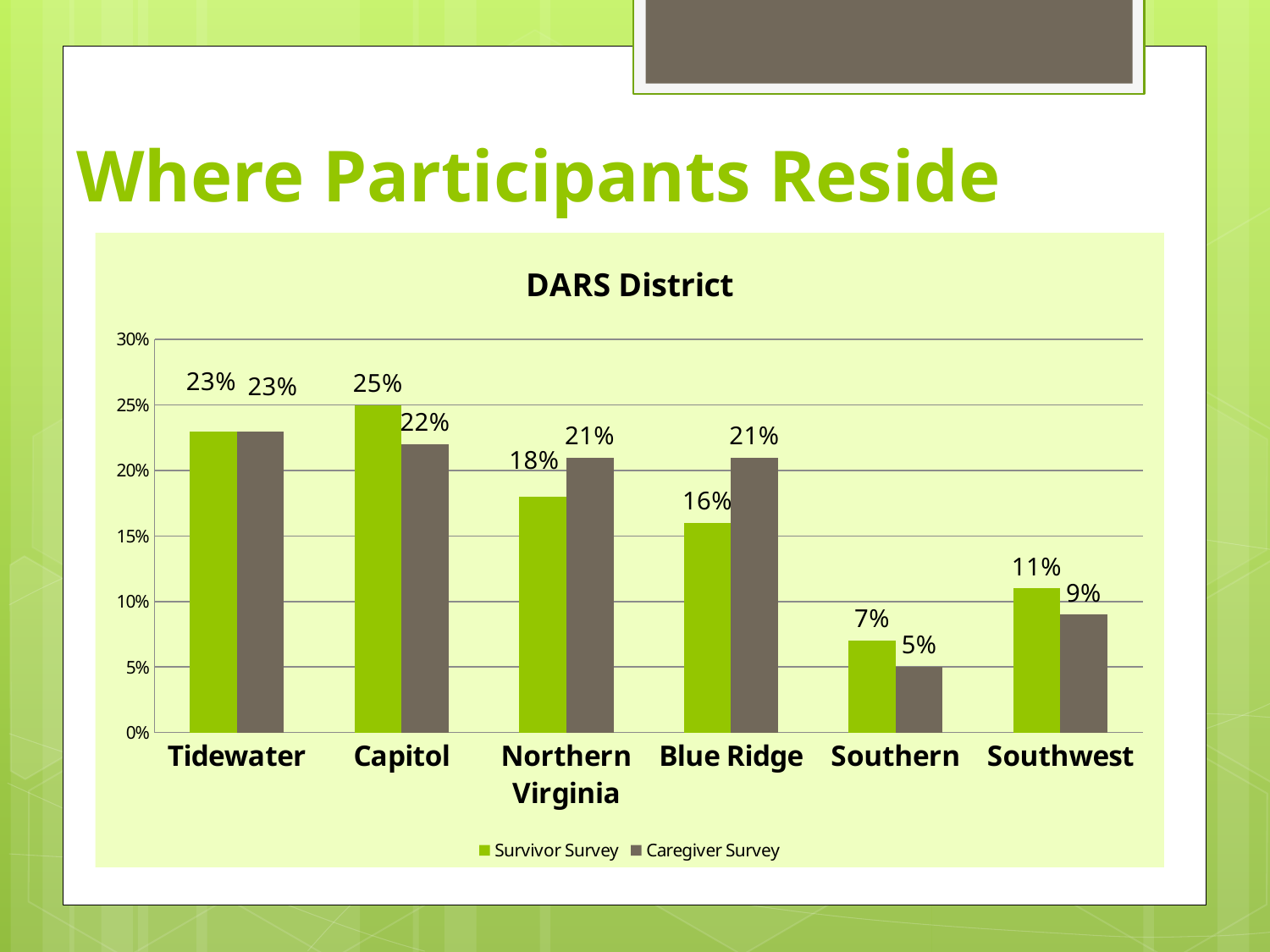
How many districts are shown on the x axis? 6 Which district has the highest Survivor Survey value? Capitol What is the Caregiver Survey value for Southern? 5% What is the Survivor Survey value for Blue Ridge? 16% What is the title of the chart? DARS District Which series is shown in green? Survivor Survey How many series does the legend list? 2 What kind of chart is shown on the slide? Bar chart What is the Survivor Survey value for Capitol? 25% Which is larger for Blue Ridge: the Survivor Survey value or the Caregiver Survey value? Caregiver Survey What is the difference between the Survivor Survey and Caregiver Survey values for Northern Virginia? 3% Which district has the lowest Caregiver Survey value? Southern